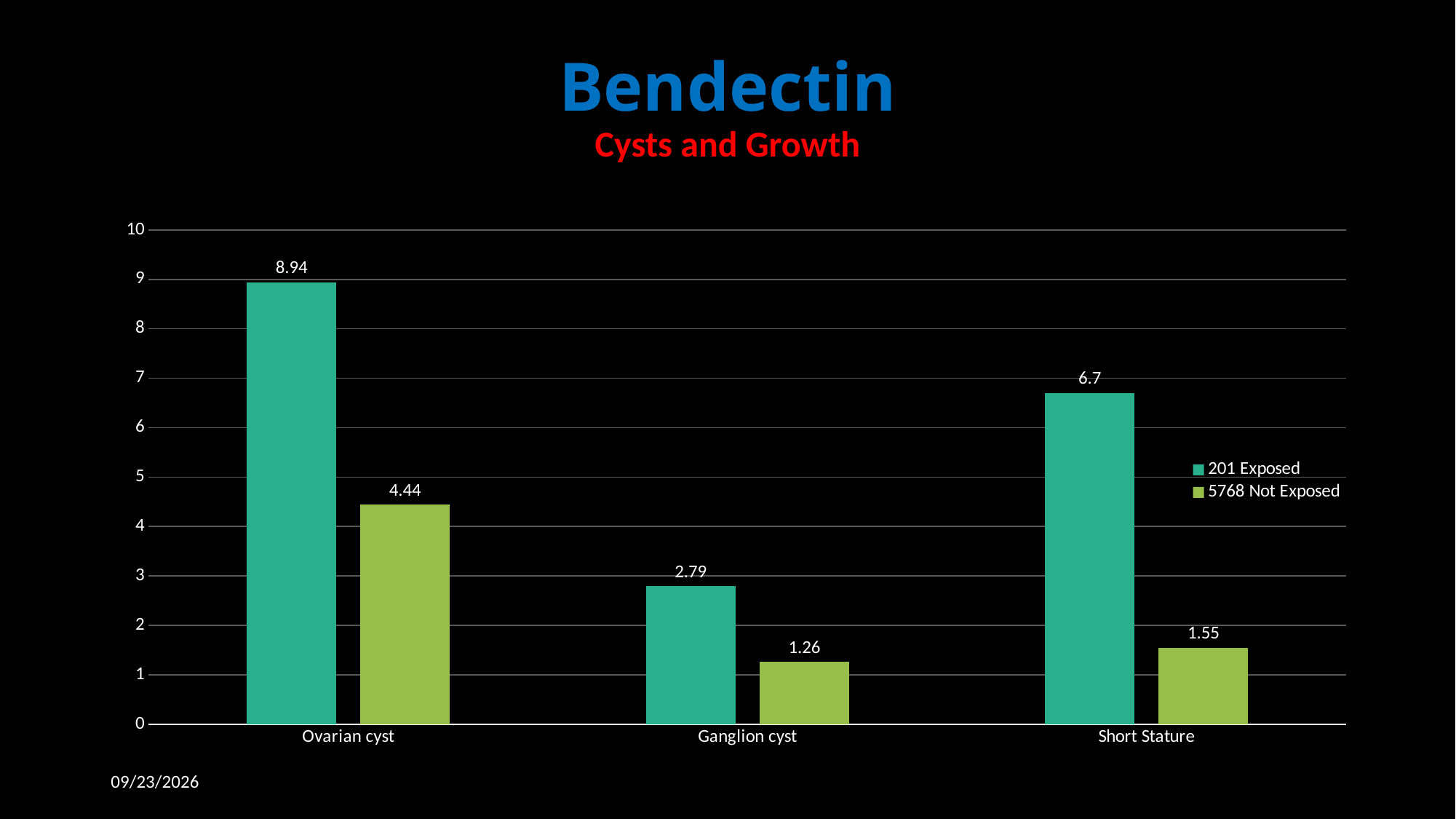
What is the difference between the 201 Exposed and 5768 Not Exposed values for Ovarian cyst? 4.5 What is the value for Short Stature in the 201 Exposed series? 6.7 What is the subtitle of the chart shown in red? Cysts and Growth What is the value for Ganglion cyst in the 5768 Not Exposed series? 1.26 Which category has the lowest value in the 5768 Not Exposed series? Ganglion cyst What kind of chart is shown on the slide? Bar chart How many categories are shown on the x axis? 3 What is the difference between the 201 Exposed and 5768 Not Exposed values for Short Stature? 5.15 Which category has the highest value in the 201 Exposed series? Ovarian cyst How many series does the legend list? 2 Which is larger for Ganglion cyst: the 201 Exposed value or the 5768 Not Exposed value? 201 Exposed What is the value for Ovarian cyst in the 201 Exposed series? 8.94